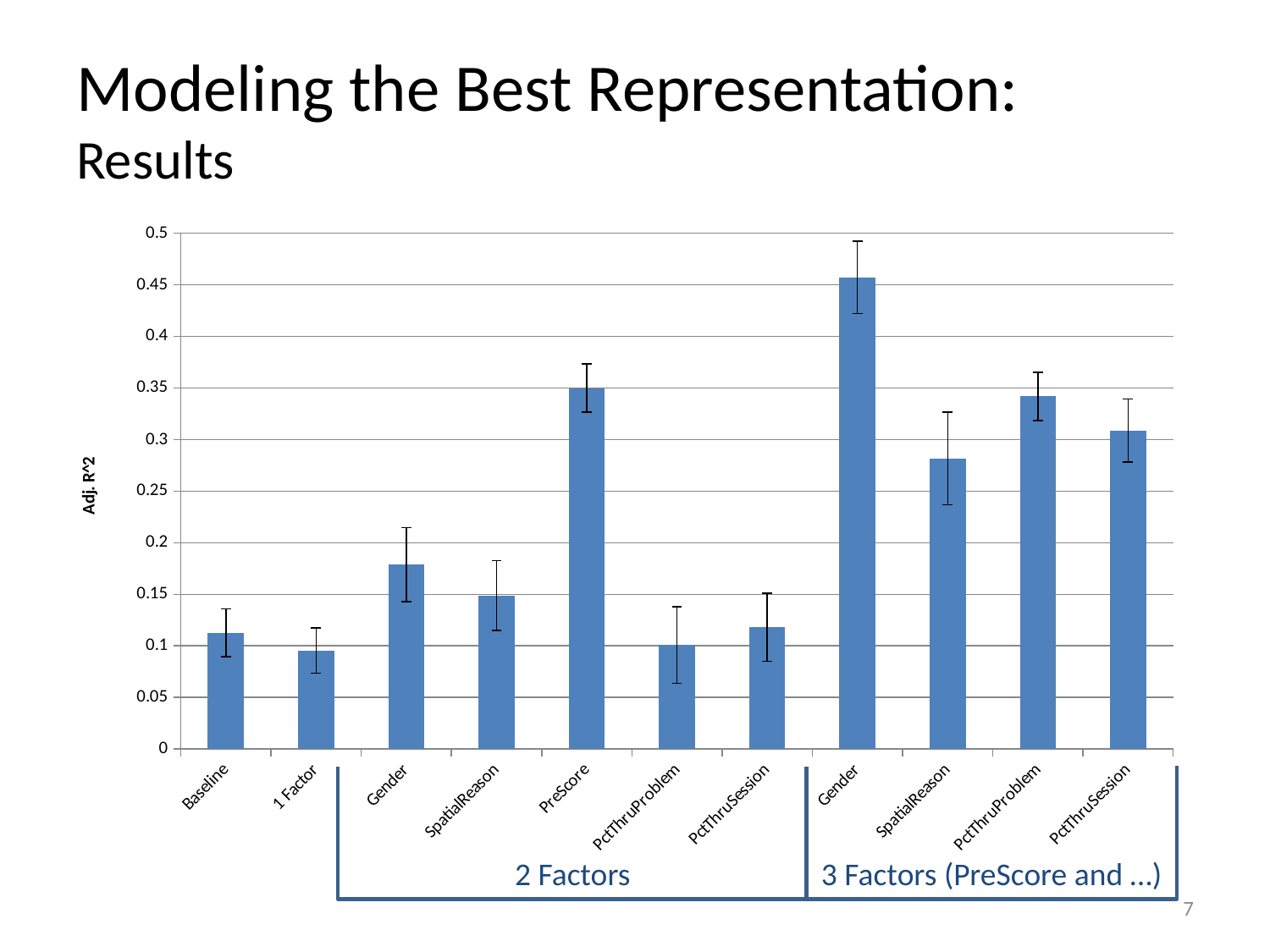
What is the label of the vertical axis? Adj. R^2 Which is larger, the value for Gender in the 3 Factors group or the value for PctThruProblem in the 3 Factors group? Gender (3 Factors) Which bar has the highest Adj. R^2 value? Gender (3 Factors) Is the value for PctThruSession in the 2 Factors group greater or less than 0.15? less Which is larger, the value for PreScore in the 2 Factors group or the value for Gender in the 2 Factors group? PreScore (2 Factors) What are the two group labels shown beneath the x axis with brackets? 2 Factors; 3 Factors (PreScore and ...) Is the value for SpatialReason in the 3 Factors group greater or less than 0.25? greater Is the value for Gender in the 2 Factors group greater or less than 0.2? less How many bars are plotted in the chart? 11 What kind of chart is shown on the slide? bar chart